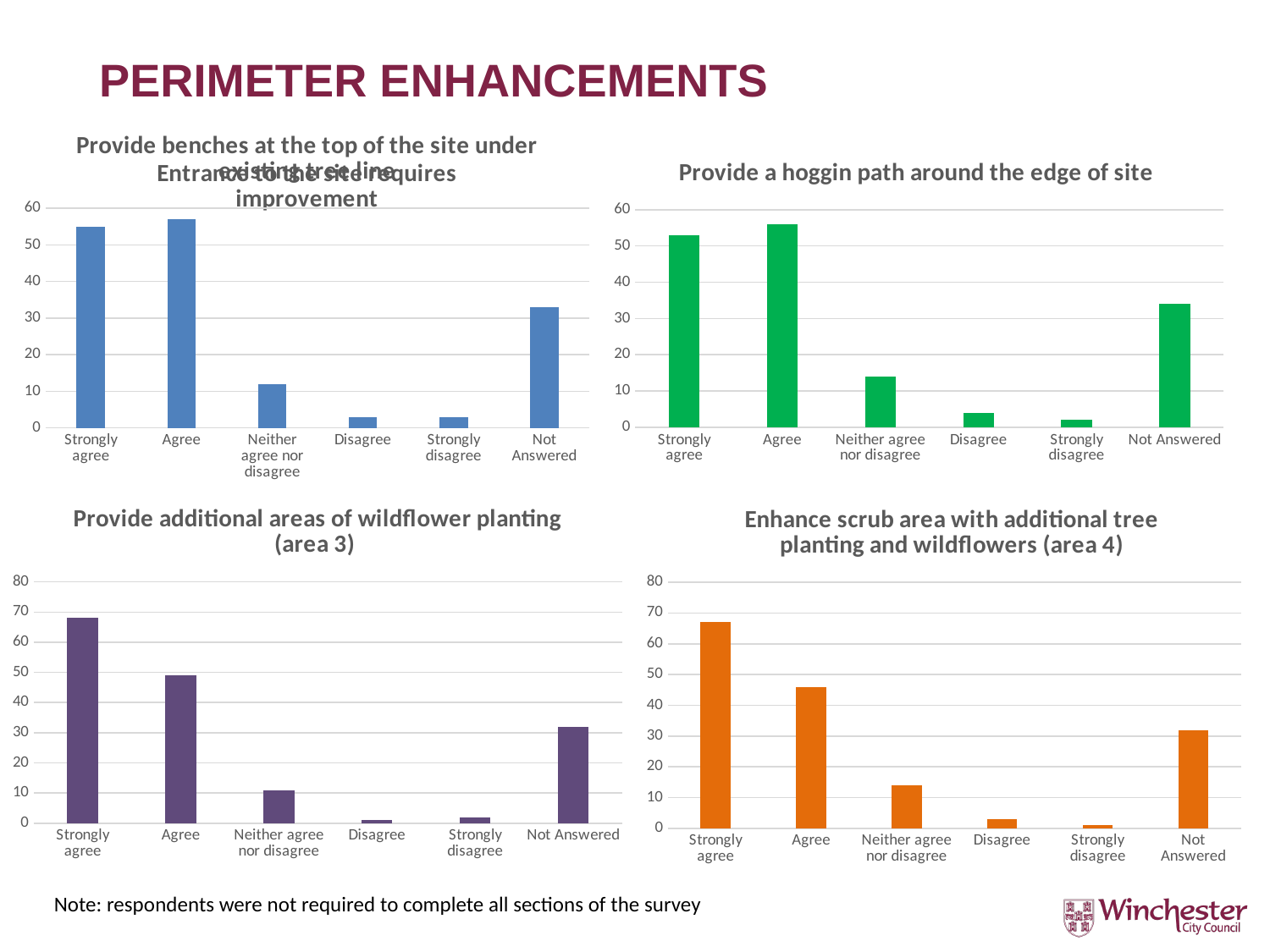
In the top-left chart, is the value for Neither agree nor disagree greater or less than 20? less In the chart titled 'Provide additional areas of wildflower planting (area 3)', which is larger, Agree or Not Answered? Agree In the chart titled 'Enhance scrub area with additional tree planting and wildflowers (area 4)', which category has the highest value? Strongly agree How many categories are shown on the x axis of the chart titled 'Provide a hoggin path around the edge of site'? 6 In the chart titled 'Provide additional areas of wildflower planting (area 3)', which category has the highest value? Strongly agree What kind of chart is the chart titled 'Enhance scrub area with additional tree planting and wildflowers (area 4)'? bar chart In the chart titled 'Enhance scrub area with additional tree planting and wildflowers (area 4)', which is larger, Neither agree nor disagree or Not Answered? Not Answered In the chart titled 'Provide a hoggin path around the edge of site', is the value for Not Answered greater or less than 30? greater In the chart titled 'Provide a hoggin path around the edge of site', which category has the lowest value? Strongly disagree In the chart titled 'Enhance scrub area with additional tree planting and wildflowers (area 4)', is the value for Agree greater or less than 50? less In the chart titled 'Provide a hoggin path around the edge of site', which category has the highest value? Agree